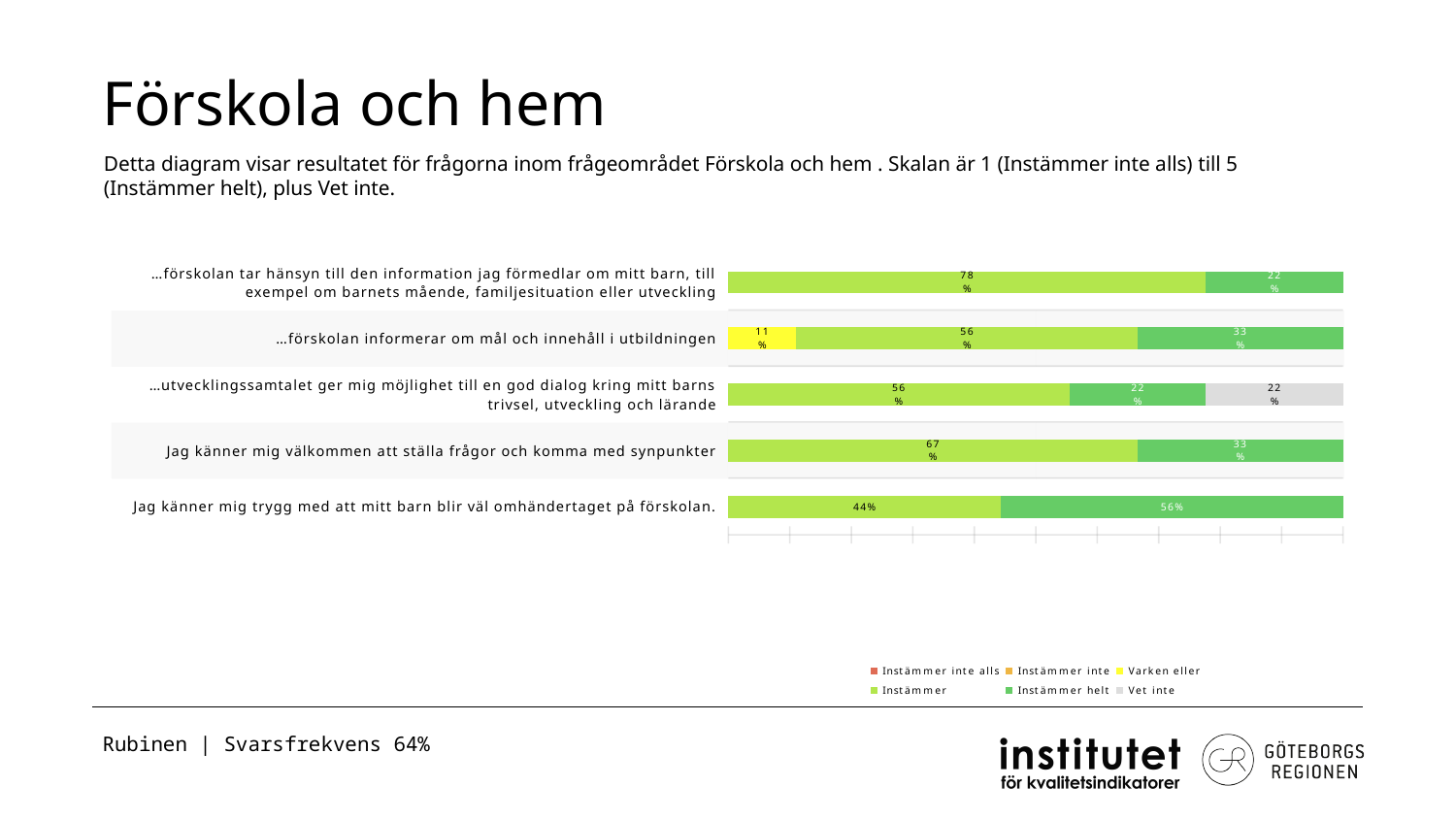
What is the 'Instämmer' value for 'Jag känner mig trygg med att mitt barn blir väl omhändertaget på förskolan.'? 44% Which statement has the highest 'Instämmer' value? …förskolan tar hänsyn till den information jag förmedlar om mitt barn, till exempel om barnets mående, familjesituation eller utveckling What is the 'Varken eller' value for '…förskolan informerar om mål och innehåll i utbildningen'? 11% Which statement has the highest 'Instämmer helt' value? Jag känner mig trygg med att mitt barn blir väl omhändertaget på förskolan. How many series does the legend list? 6 What is the difference between the 'Instämmer' and 'Instämmer helt' values for '…förskolan tar hänsyn till den information jag förmedlar om mitt barn, till exempel om barnets mående, familjesituation eller utveckling'? 56% What is the 'Vet inte' value for '…utvecklingssamtalet ger mig möjlighet till en god dialog kring mitt barns trivsel, utveckling och lärande'? 22% How many statements are shown in the chart? 5 For 'Jag känner mig trygg med att mitt barn blir väl omhändertaget på förskolan.', which is larger: 'Instämmer' or 'Instämmer helt'? Instämmer helt What kind of chart is shown on the slide? Stacked bar chart What is the 'Instämmer helt' value for 'Jag känner mig välkommen att ställa frågor och komma med synpunkter'? 33% What is the combined 'Instämmer' and 'Instämmer helt' share for '…utvecklingssamtalet ger mig möjlighet till en god dialog kring mitt barns trivsel, utveckling och lärande'? 78%